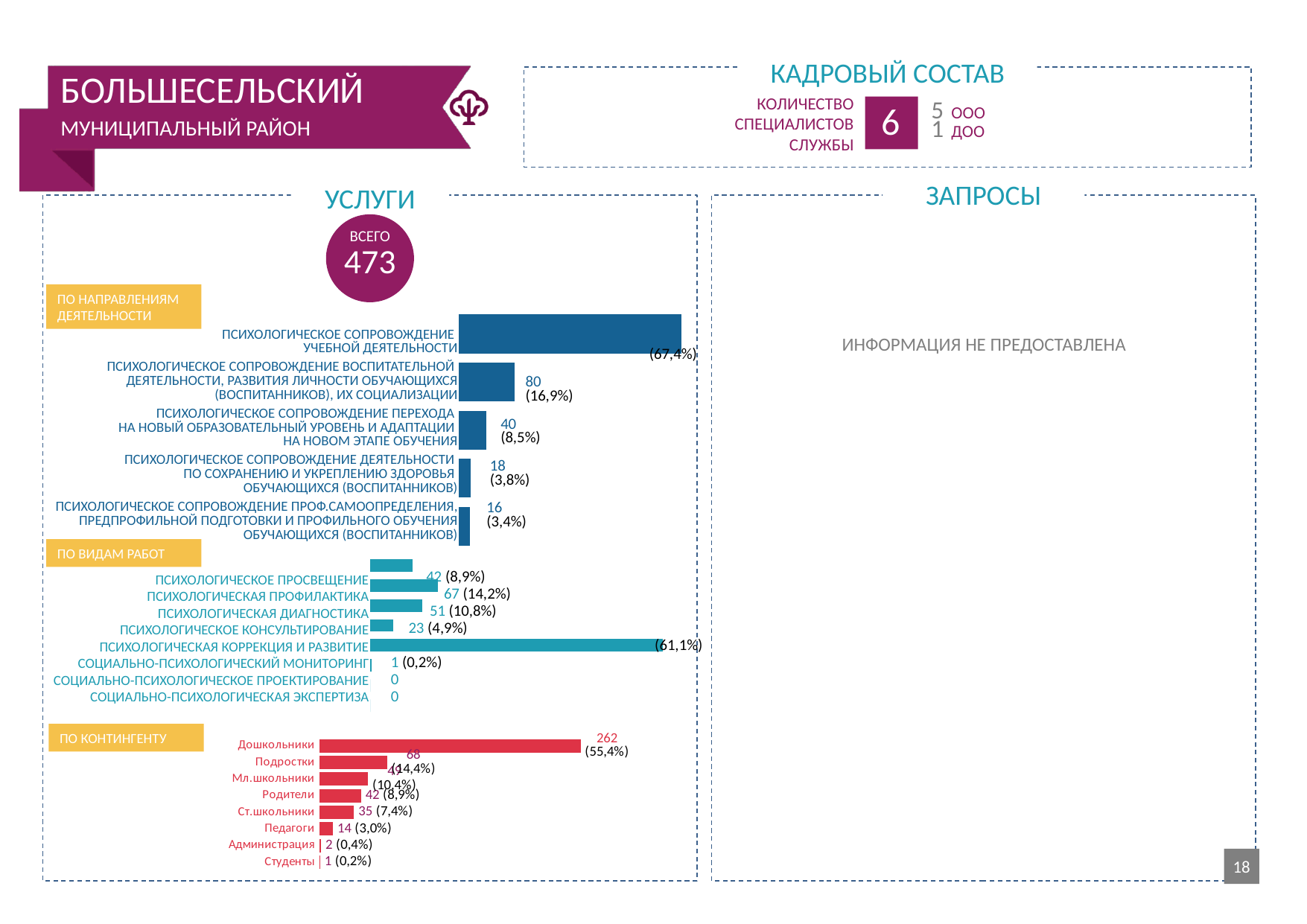
What type of chart is used in the 'По контингенту' section? Bar chart In the 'По контингенту' chart, what is the difference between the values for 'Подростки' and 'Ст.школьники'? 33 In the 'По направлениям деятельности' chart, what is the value for 'Психологическое сопровождение перехода на новый образовательный уровень и адаптации на новом этапе обучения'? 40 (8,5%) In the 'По видам работ' chart, what is the value for 'Психологическая профилактика'? 67 (14,2%) In the 'По видам работ' chart, which category has the highest value? Психологическая коррекция и развитие In the 'По направлениям деятельности' chart, what is the difference between the values for 'Психологическое сопровождение воспитательной деятельности...' and 'Психологическое сопровождение перехода на новый образовательный уровень...'? 40 In the 'По направлениям деятельности' chart, which category has the lowest value? Психологическое сопровождение проф.самоопределения, предпрофильной подготовки и профильного обучения обучающихся (воспитанников) In the 'По видам работ' chart, how many categories are listed? 8 In the 'По контингенту' chart, which category has the lowest value? Студенты In the 'По направлениям деятельности' chart, what percentage is shown for 'Психологическое сопровождение учебной деятельности'? 67,4% In the 'По видам работ' chart, which is larger: 'Психологическая диагностика' or 'Психологическое консультирование'? Психологическая диагностика In the 'По контингенту' chart, what is the value for 'Дошкольники'? 262 (55,4%)